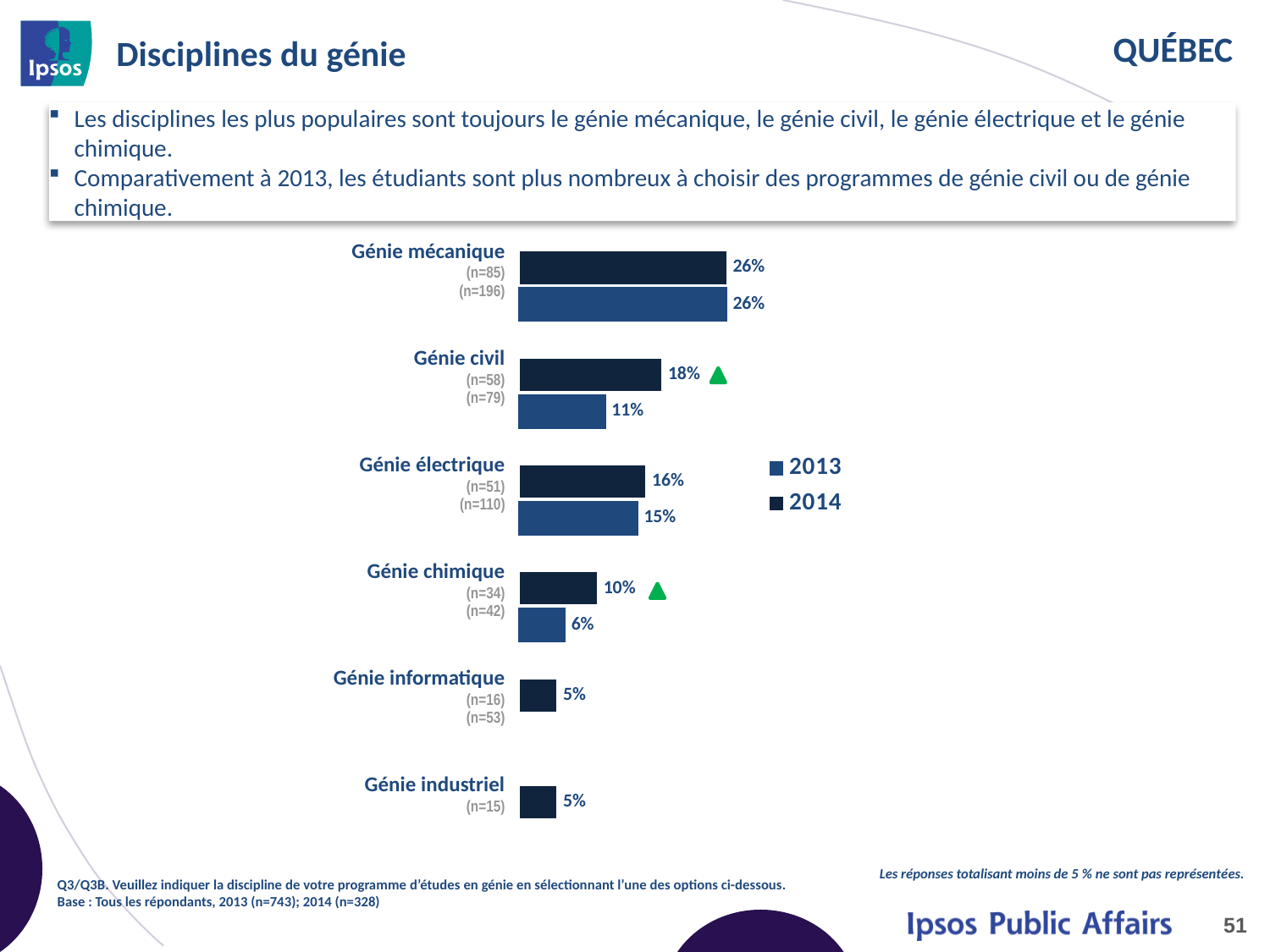
What is the 2013 value for Génie chimique? 6% What is the 2014 value for Génie civil? 18% What is the difference between the 2014 and 2013 values for Génie civil? 7 percentage points Which discipline has the lowest 2013 value shown? Génie chimique What is the 2014 value for Génie industriel? 5% Which is larger for Génie chimique, the 2014 value or the 2013 value? 2014 Which discipline has the highest 2014 value? Génie mécanique Which series is shown in the darker navy colour? 2014 How many series does the legend list? 2 How many disciplines are shown on the chart? 6 What is the 2013 value for Génie électrique? 15% What kind of chart is shown on the slide? Bar chart